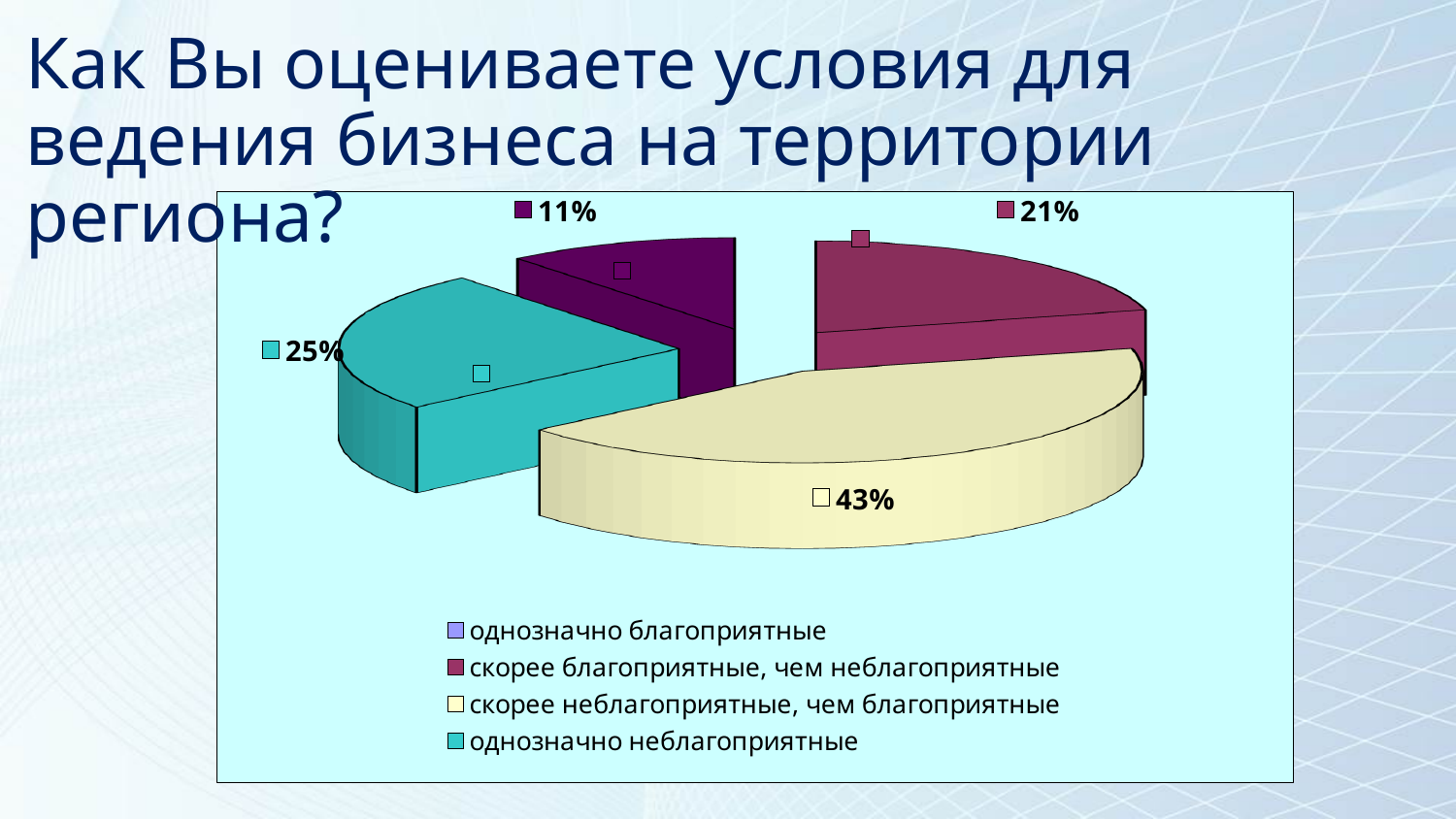
How many slices does the pie chart have? 4 What share of respondents answered «скорее неблагоприятные, чем благоприятные»? 43% Which is larger: the share for «однозначно неблагоприятные» or the share for «скорее благоприятные, чем неблагоприятные»? однозначно неблагоприятные What question is the chart on the slide answering, according to the slide title? Как Вы оцениваете условия для ведения бизнеса на территории региона? What is the difference in percentage points between «скорее неблагоприятные, чем благоприятные» and «однозначно неблагоприятные»? 18 What kind of chart is shown on the slide? pie chart What share of respondents answered «однозначно неблагоприятные»? 25% Which answer option has the largest share of the pie? скорее неблагоприятные, чем благоприятные How many entries does the legend list? 4 What share of respondents answered «скорее благоприятные, чем неблагоприятные»? 21%